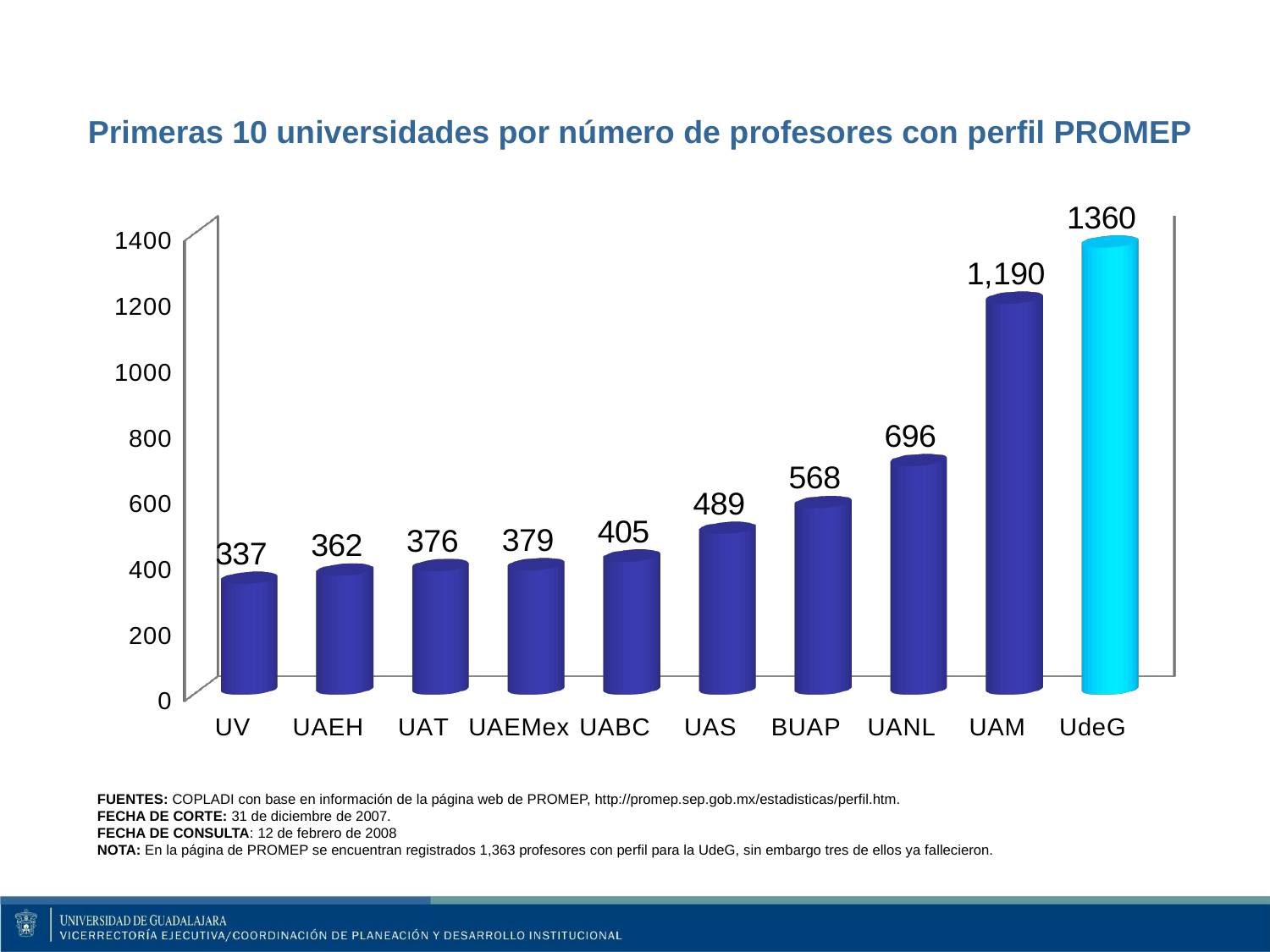
Which is larger, the value for UAEH or the value for UABC? UABC Is the value for UAM greater or less than 1000? greater What is the value for UdeG? 1360 What kind of chart is shown on the slide? bar chart Do the values rise or fall from left to right along the x axis? rise What is the value for UAM? 1,190 Which bar is shown in a different colour (light blue) from the others? UdeG What is the difference between the values for UANL and UAS? 207 Which university has the lowest value on the chart? UV Which university has the highest number of professors with PROMEP profile? UdeG How many universities are shown on the chart? 10 What is the value for BUAP? 568